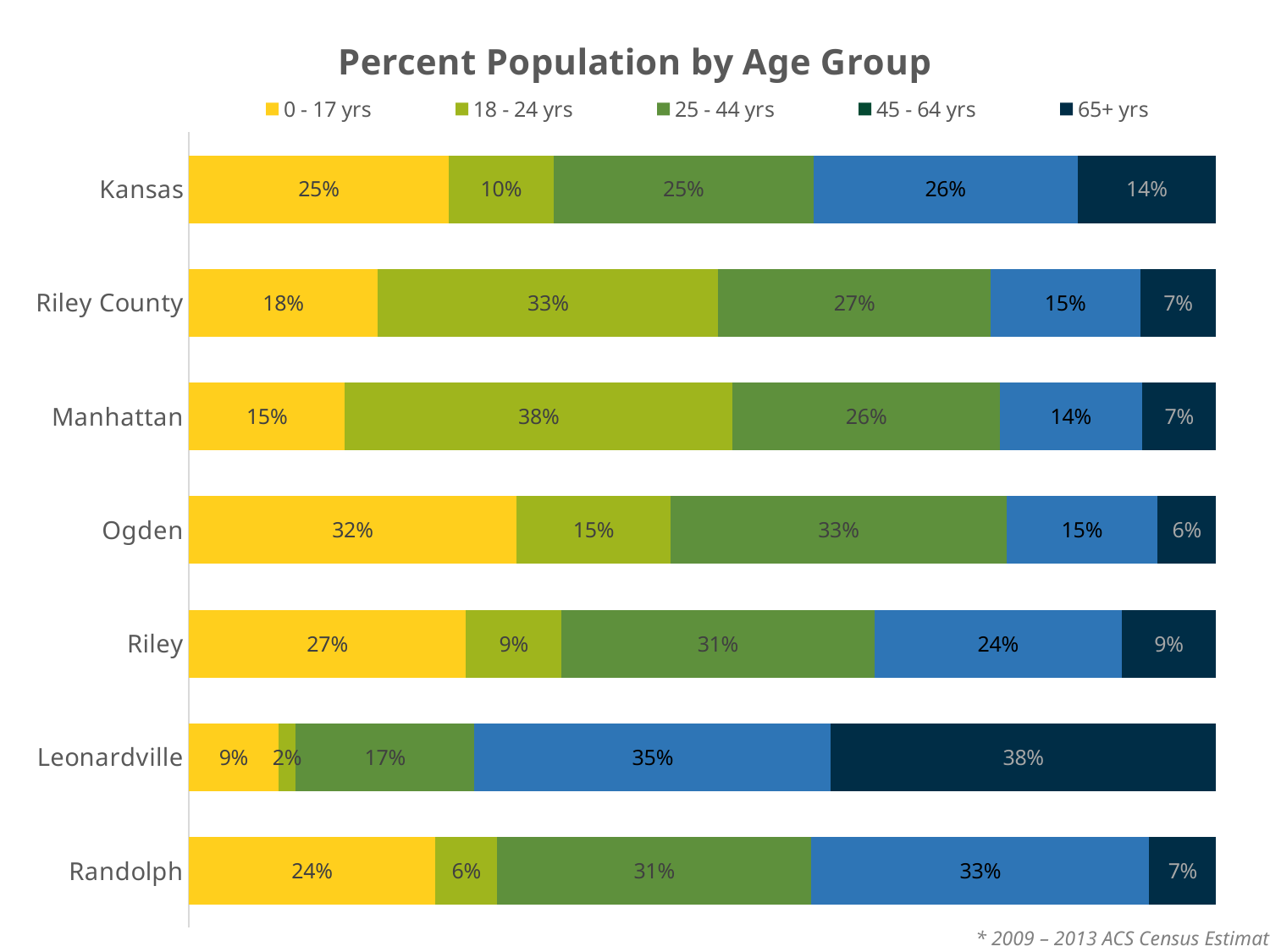
What is the value for the 65+ yrs age group in Leonardville? 38% What share of Ogden's population is 0 - 17 yrs? 32% How much larger is the 18 - 24 yrs value for Riley County than for Kansas? 23 percentage points Which has a larger 45 - 64 yrs value, Randolph or Riley? Randolph What percentage of Manhattan's population is in the 18 - 24 yrs age group? 38% What is the total of the stacked bar for Kansas? 100% How many locations are shown on the chart? 7 What type of chart is shown on the slide? Stacked bar chart Which location has the highest value for the 0 - 17 yrs age group? Ogden How many age groups does the legend list? 5 Which location has the lowest value for the 18 - 24 yrs age group? Leonardville What is the title of the chart? Percent Population by Age Group